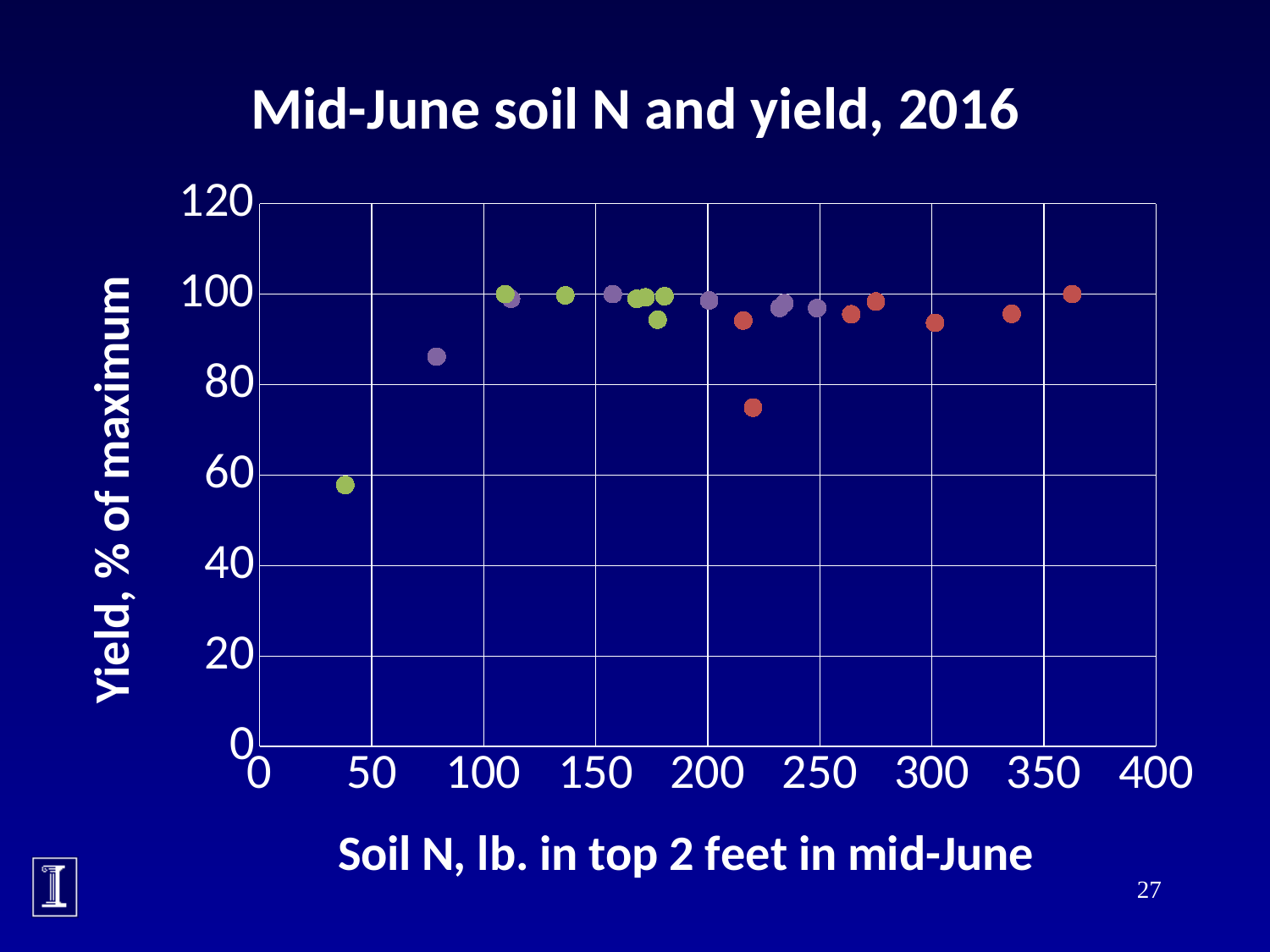
Is the lowest yield value plotted greater or less than 80? less What is the title of the chart? Mid-June soil N and yield, 2016 What is the highest value shown on the horizontal axis? 400 As soil N increases from 0 to 100 lb, do the plotted yields rise or fall? rise What is the label of the vertical axis? Yield, % of maximum Is the yield for the point plotted near 220 lb soil N with the lowest yield greater or less than 80? less Is the yield for the point plotted near 80 lb soil N greater or less than 80? greater Does the point with the lowest yield also have the lowest soil N? Yes What kind of chart is shown on the slide? Scatter chart What is the highest value shown on the vertical axis? 120